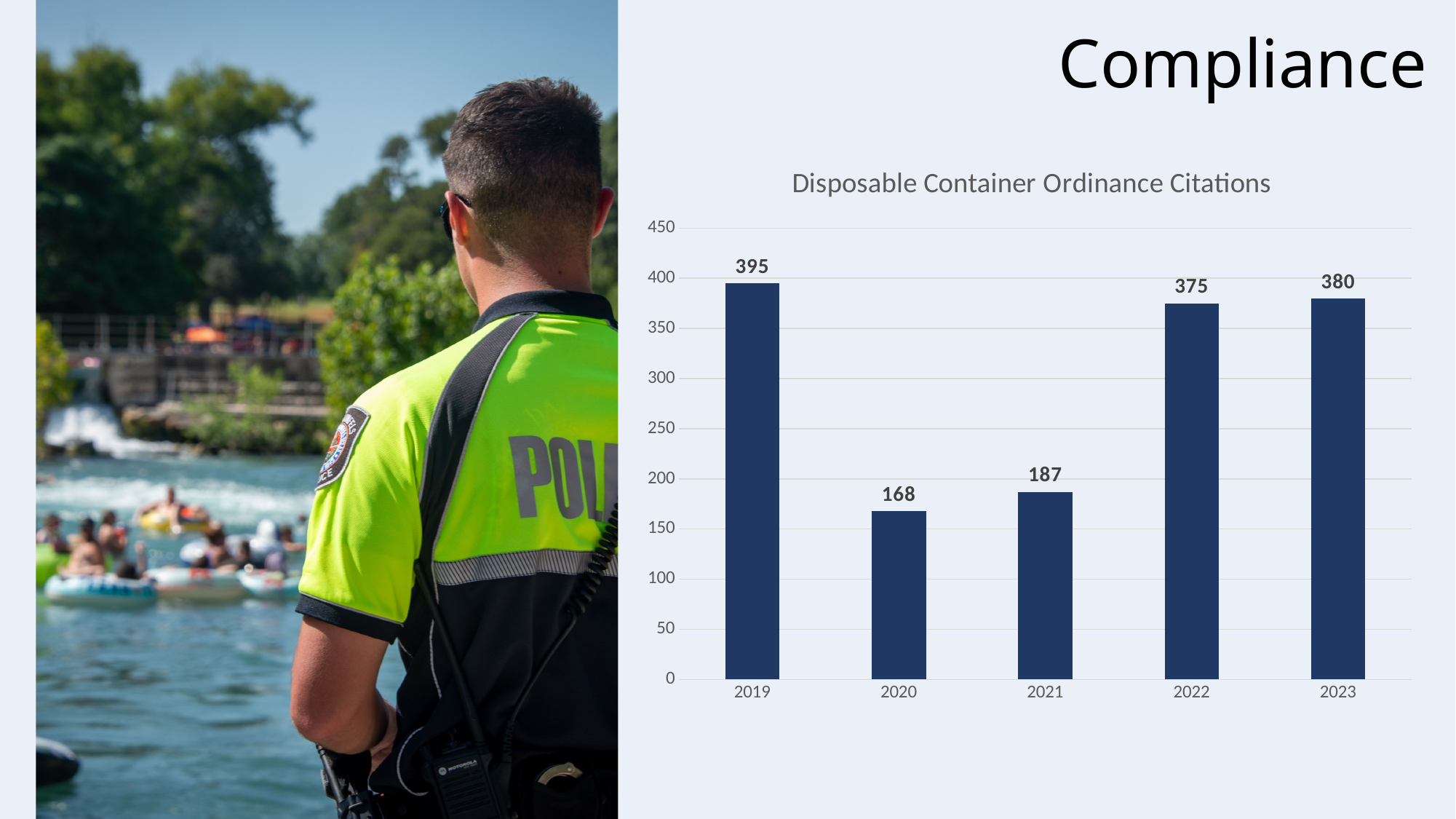
What is the value for 2020 in the Disposable Container Ordinance Citations chart? 168 What is the difference between the citations in 2023 and 2022? 5 Is the value for 2021 greater or less than 200? less What is the value for 2022 in the Disposable Container Ordinance Citations chart? 375 What kind of chart is shown on the slide? bar chart What is the value for 2019 in the Disposable Container Ordinance Citations chart? 395 What is the title of the chart on the slide? Disposable Container Ordinance Citations What is the difference between the citations in 2019 and 2020? 227 Which year has the lowest number of citations? 2020 Which year has the highest number of citations? 2019 Which year had more citations, 2021 or 2022? 2022 How many years are shown on the x axis of the chart? 5